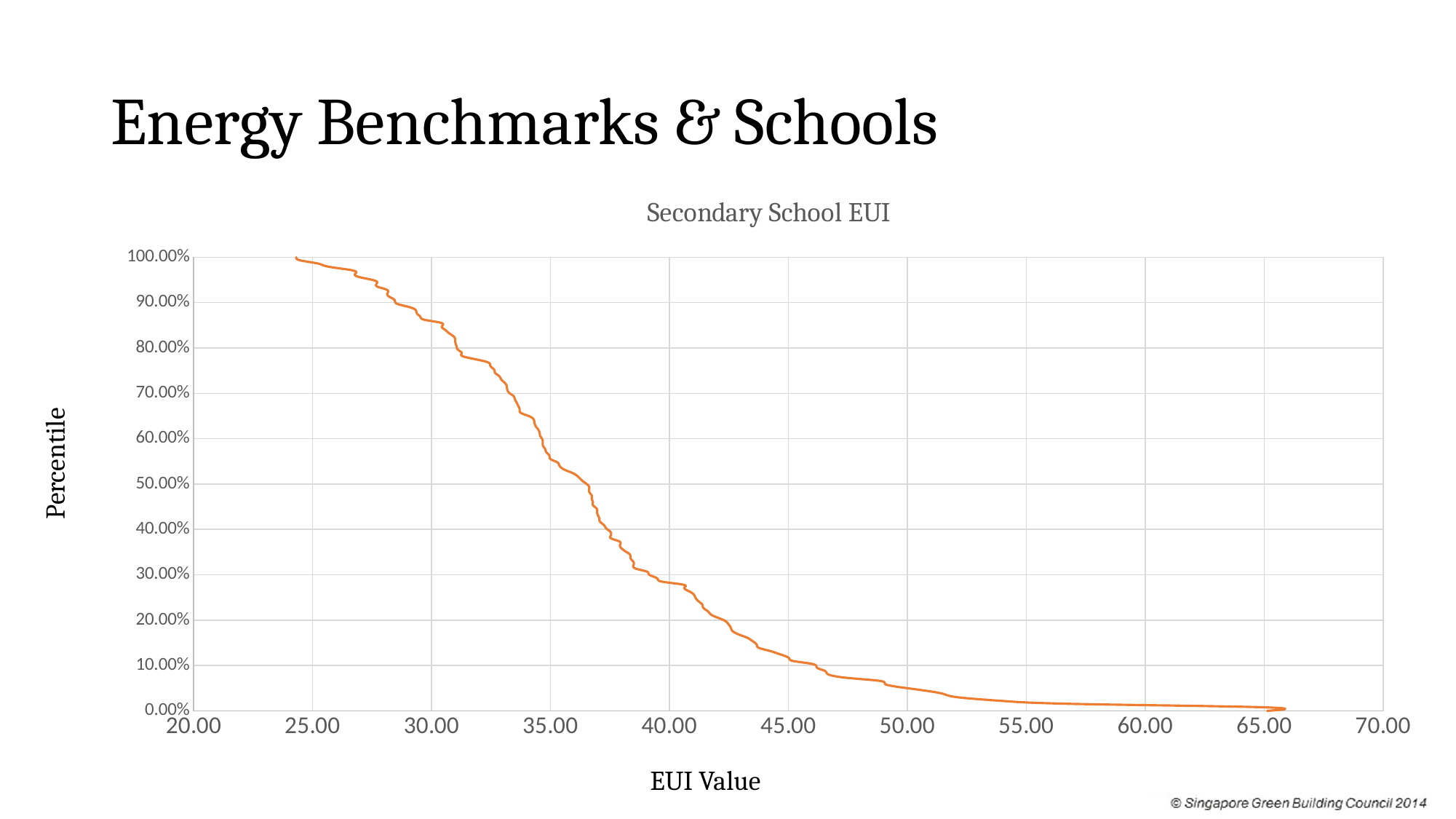
Is the percentile at an EUI Value of 25.00 greater or less than 90.00%? greater What kind of chart is shown on the slide? Line chart Is the percentile at an EUI Value of 50.00 greater or less than 10.00%? less Is the percentile at an EUI Value of 45.00 greater or less than 20.00%? less Is the percentile higher at an EUI Value of 30.00 or at an EUI Value of 40.00? 30.00 What is the title of the chart? Secondary School EUI What is the highest value shown on the x axis of the chart? 70.00 Does the percentile rise or fall as the EUI Value increases along the x axis? Fall What is the label of the x axis of the chart? EUI Value